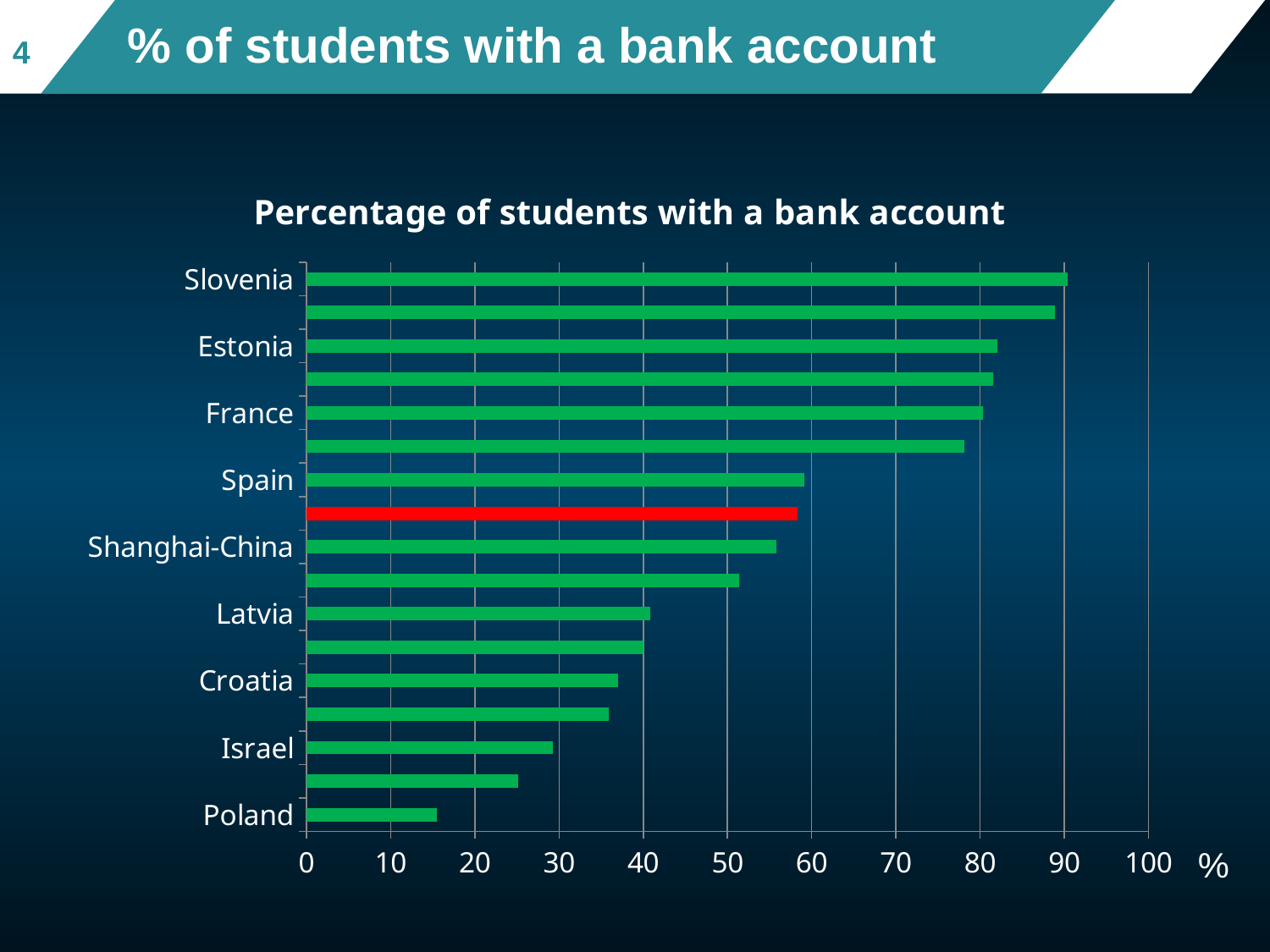
What is the title of the chart? Percentage of students with a bank account Which labelled country has the highest percentage of students with a bank account? Slovenia Is the value for Israel greater or less than 40? less Is the value for Latvia greater or less than 50? less Is the value for Spain greater or less than 50? greater What kind of chart is shown on the slide? bar chart Which has a higher percentage of students with a bank account, Croatia or Spain? Spain Which has a higher percentage of students with a bank account, France or Latvia? France Which labelled country has the lowest percentage of students with a bank account? Poland